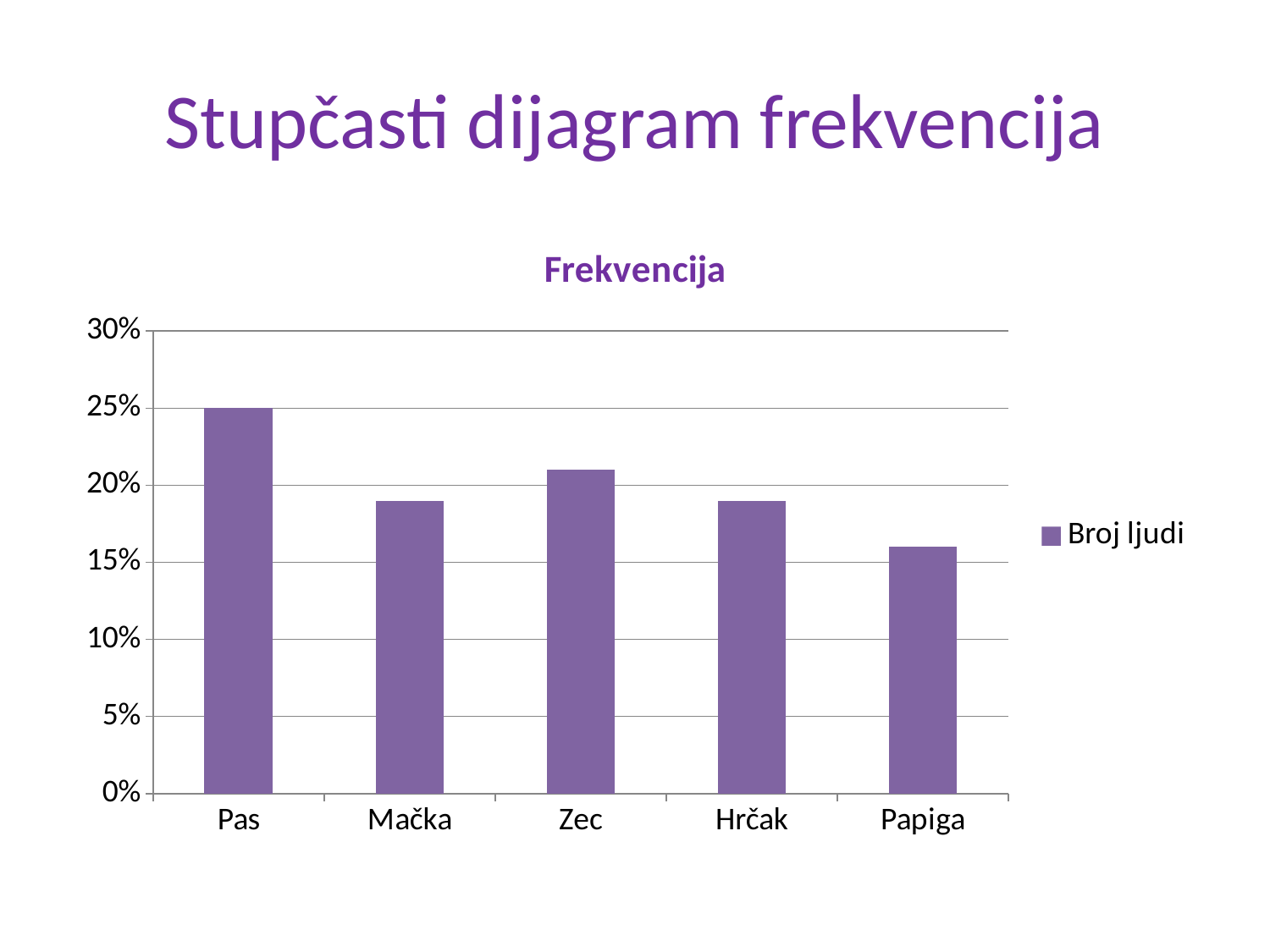
How many categories are shown on the x axis of the chart? 5 Which is larger, the value for Zec or the value for Papiga? Zec Which category has the lowest value? Papiga Is the value for Mačka greater or less than 20%? less Which category has the highest value? Pas How many series does the legend list? 1 What kind of chart is shown on the slide? bar chart What is the title of the chart? Frekvencija Is the value for Papiga greater or less than 15%? greater What is the value for Pas? 25% Which is larger, the value for Pas or the value for Zec? Pas Is the value for Zec greater or less than 20%? greater